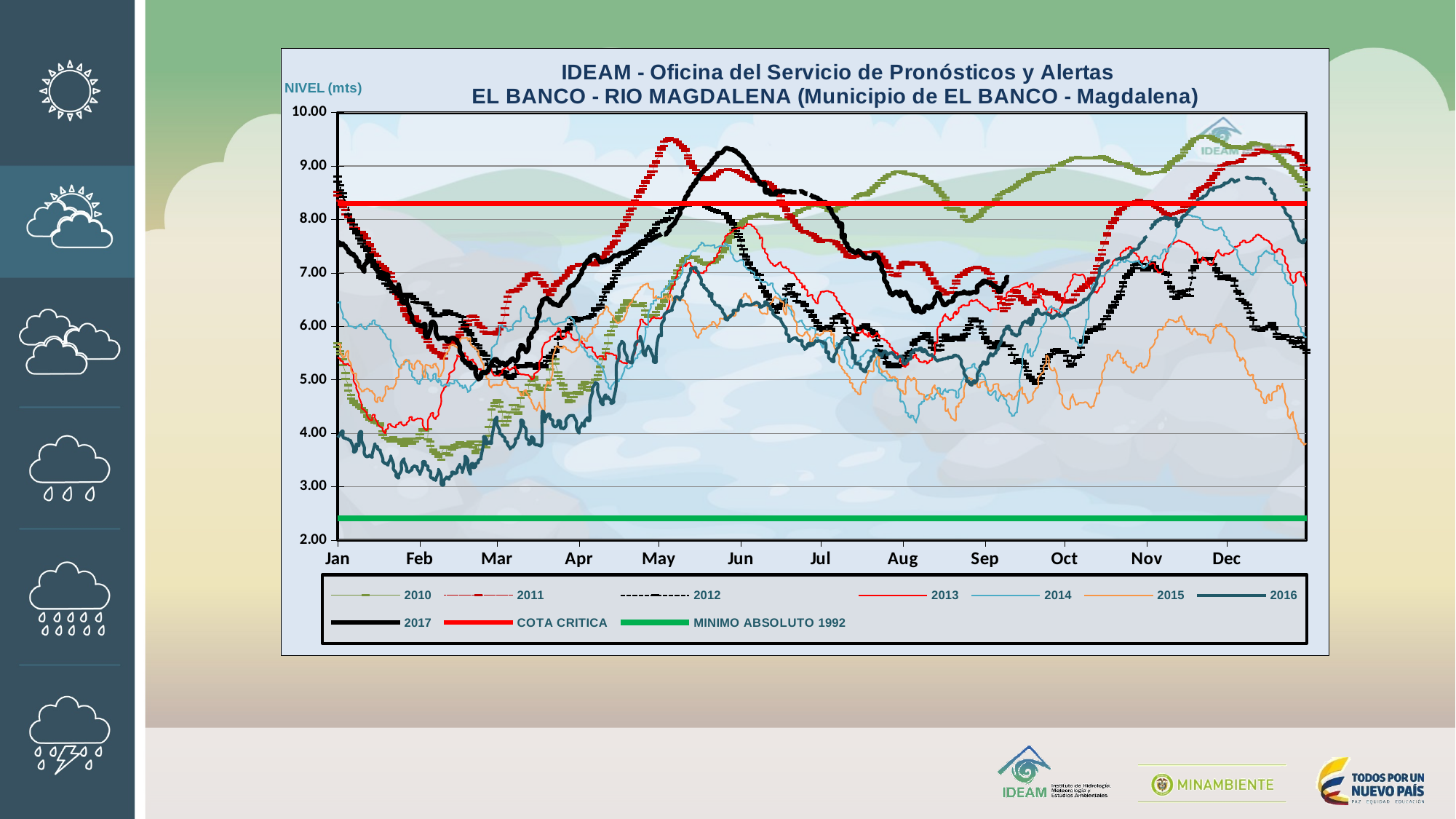
How many series does the legend list? 10 Does the 2015 series rise or fall from November to the end of December? fall Is the peak value for 2012 in late May greater or less than 9.00? greater What is the label of the y axis? NIVEL (mts) What kind of chart is shown on the slide? line chart Is the value for 2016 in February greater or less than 4.00? less How many month labels are shown along the x axis? 12 Is the COTA CRITICA line greater or less than 8.00? greater What is the legend label of the thick red horizontal line? COTA CRITICA Which year series reaches the lowest level on the chart? 2016